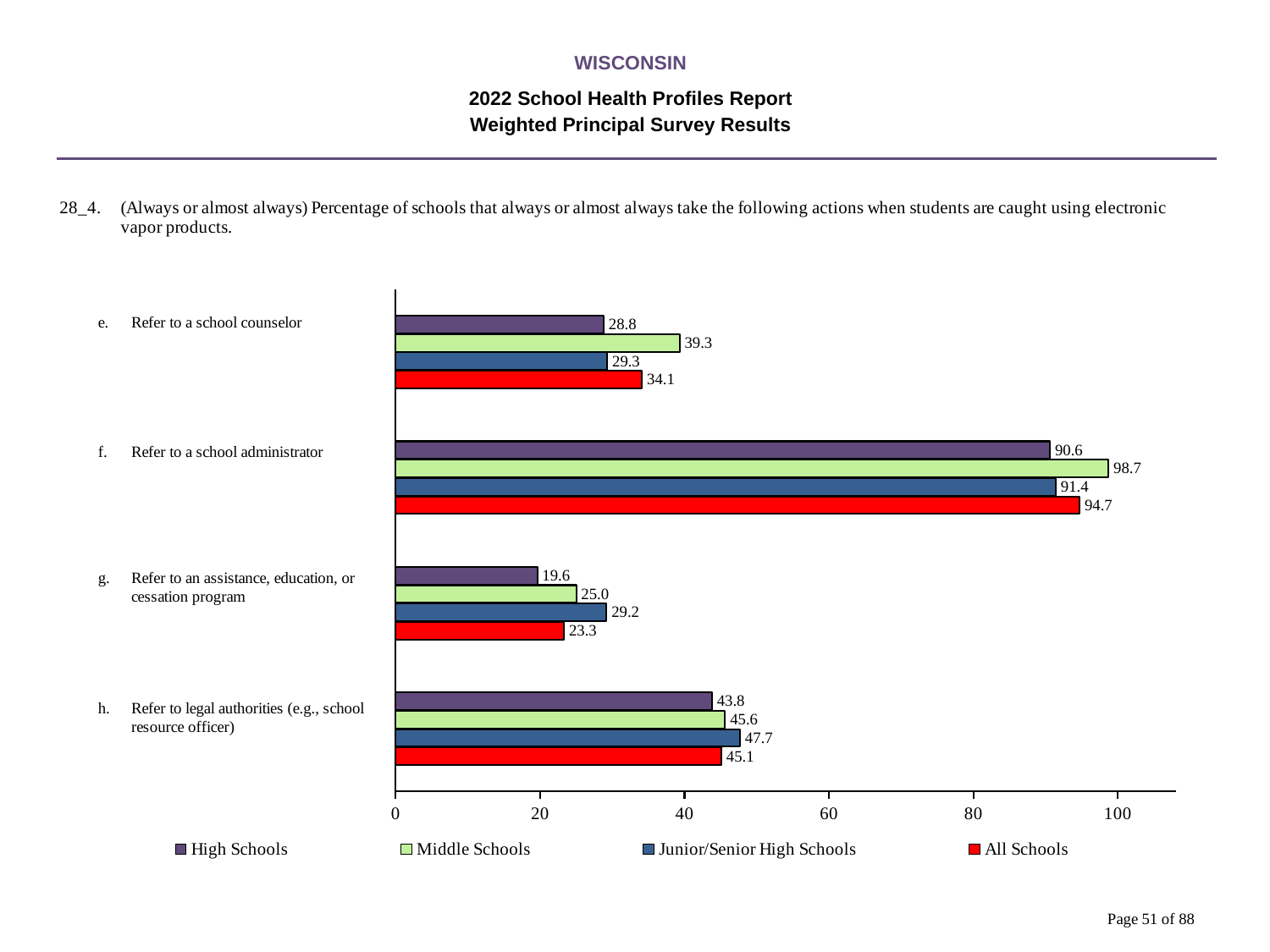
How many series does the legend list? 4 What is the value for Middle Schools for "Refer to a school administrator"? 98.7 What is the value for Junior/Senior High Schools for "Refer to legal authorities (e.g., school resource officer)"? 47.7 Which action has the highest value for All Schools? Refer to a school administrator How many actions (categories) are shown on the chart? 4 What is the value for All Schools for "Refer to a school counselor"? 34.1 For "Refer to legal authorities (e.g., school resource officer)", which is larger: the Middle Schools value or the High Schools value? Middle Schools What is the value for High Schools for "Refer to an assistance, education, or cessation program"? 19.6 Which action has the lowest value for High Schools? Refer to an assistance, education, or cessation program What kind of chart is shown on the slide? Bar chart What is the difference between the Middle Schools and High Schools values for "Refer to a school counselor"? 10.5 Is the All Schools value for "Refer to a school administrator" greater or less than 80? greater